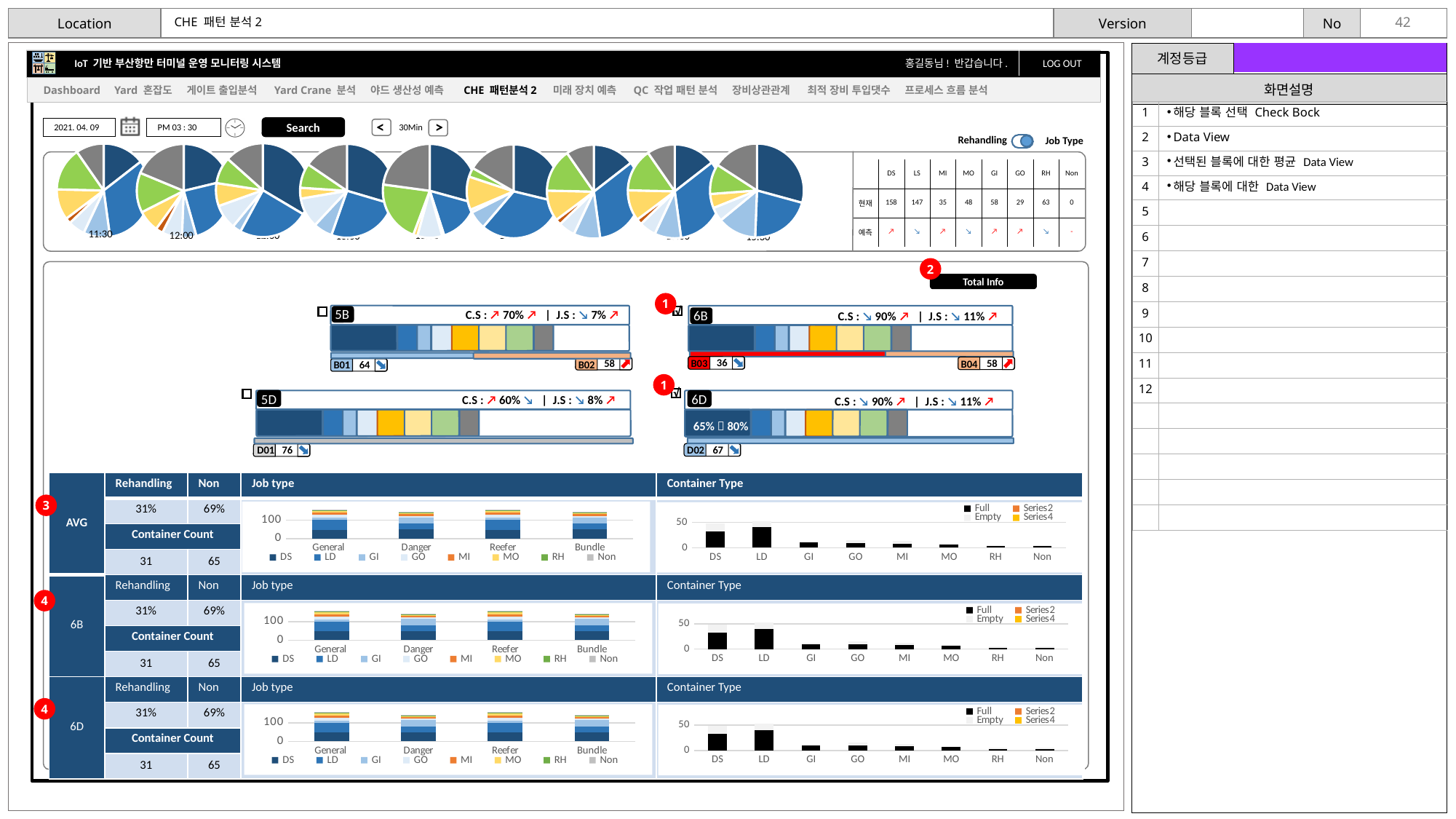
What is the first category on the x axis of the Job type chart in the 6D row? General How many series does the legend of the Job type chart in the AVG row list? 8 What kind of chart is the Container Type chart in the AVG row? bar chart How many entries does the legend of the Container Type chart in the AVG row list? 4 How many categories are shown on the x axis of the Container Type chart in the AVG row? 8 In the Container Type chart in the 6B row, which is larger, the bar for DS or the bar for GI? DS What are the legend entries of the Container Type chart in the 6D row? Full, Empty, Series2, Series4 How many categories are shown on the x axis of the Job type chart in the AVG row? 4 In the Container Type chart in the AVG row, which category has the highest bar? LD What kind of chart is the Job type chart in the 6B row? bar chart In the Container Type chart in the 6D row, which is larger, the bar for LD or the bar for DS? LD